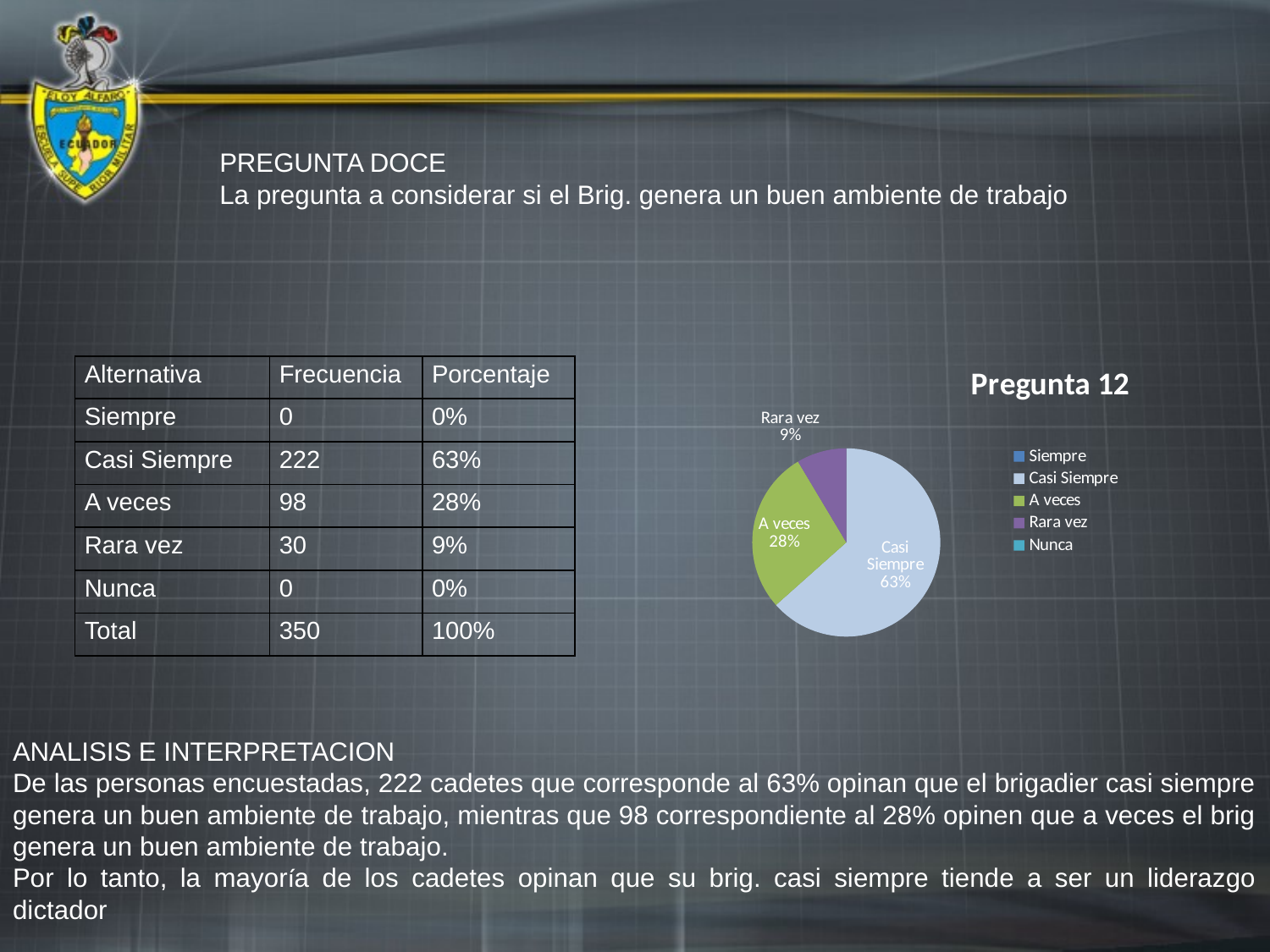
What percentage does the Rara vez slice show? 9% What colour is the Casi Siempre slice? light blue Which slice is larger, A veces or Rara vez? A veces Which of the labelled slices is the smallest? Rara vez How many entries does the legend of the pie chart list? 5 What is the difference in percentage points between the Casi Siempre and A veces slices? 35 What kind of chart is shown on the slide? pie chart Which category has the largest slice of the pie? Casi Siempre How many slices are visibly labelled on the pie chart? 3 What percentage does the Casi Siempre slice show? 63% What is the chart's title? Pregunta 12 What percentage does the A veces slice show? 28%